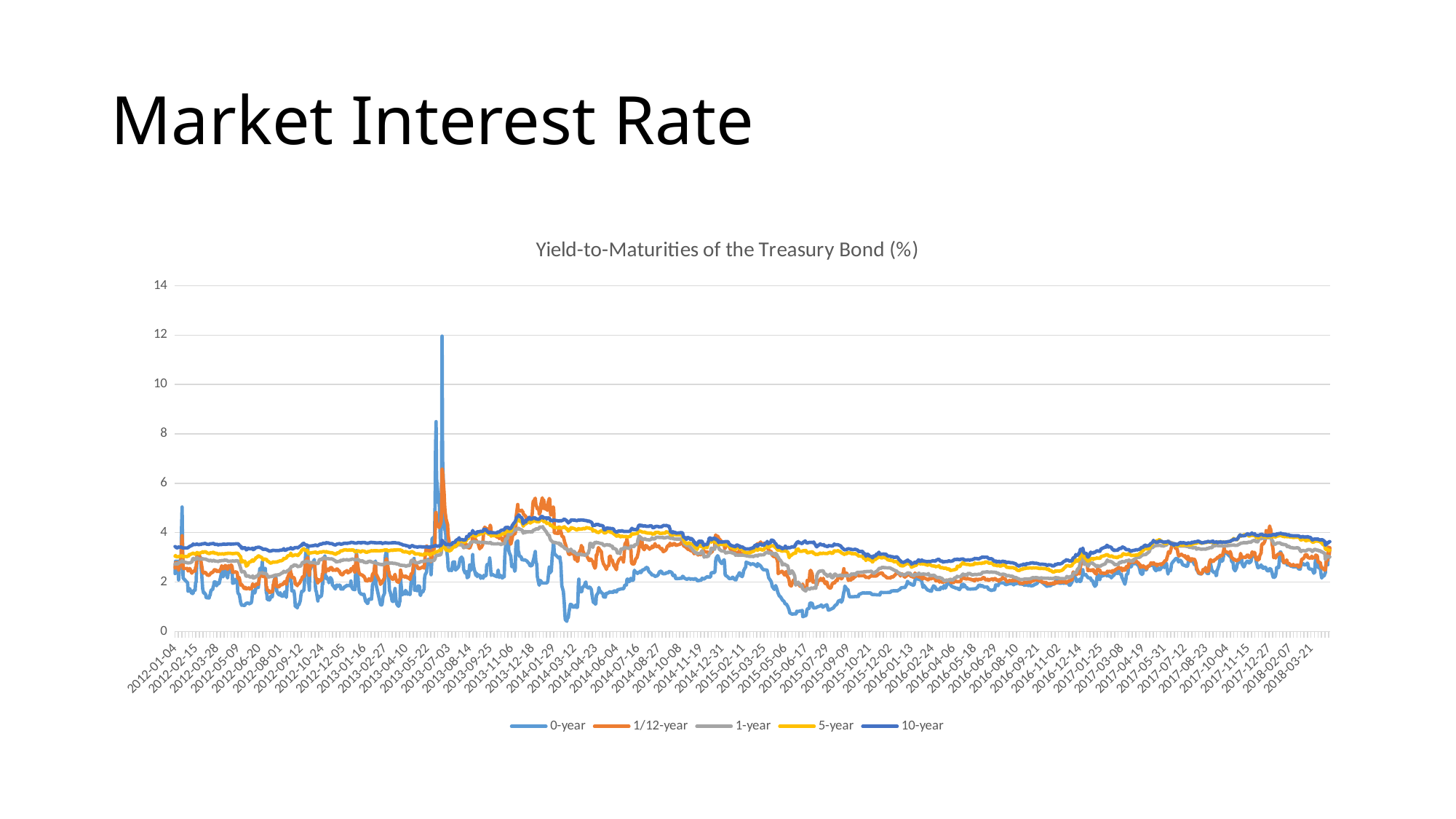
Which series are listed in the legend? 0-year, 1/12-year, 1-year, 5-year, 10-year What is the title of the chart? Yield-to-Maturities of the Treasury Bond (%) Is the value of the 10-year series at 2012-01-04 greater or less than 2? greater Around 2013-07-03, which series is larger: 0-year or 10-year? 0-year Is the peak of the 1/12-year series around 2013-07-03 greater or less than 8? less What is the highest value shown on the vertical axis? 14 Around 2015-06-17, which series is larger: 10-year or 0-year? 10-year Is the highest value of the 0-year series greater or less than 10? greater How many series does the legend list? 5 What kind of chart is shown on the slide? Line chart Which series reaches the highest peak on the chart? 0-year